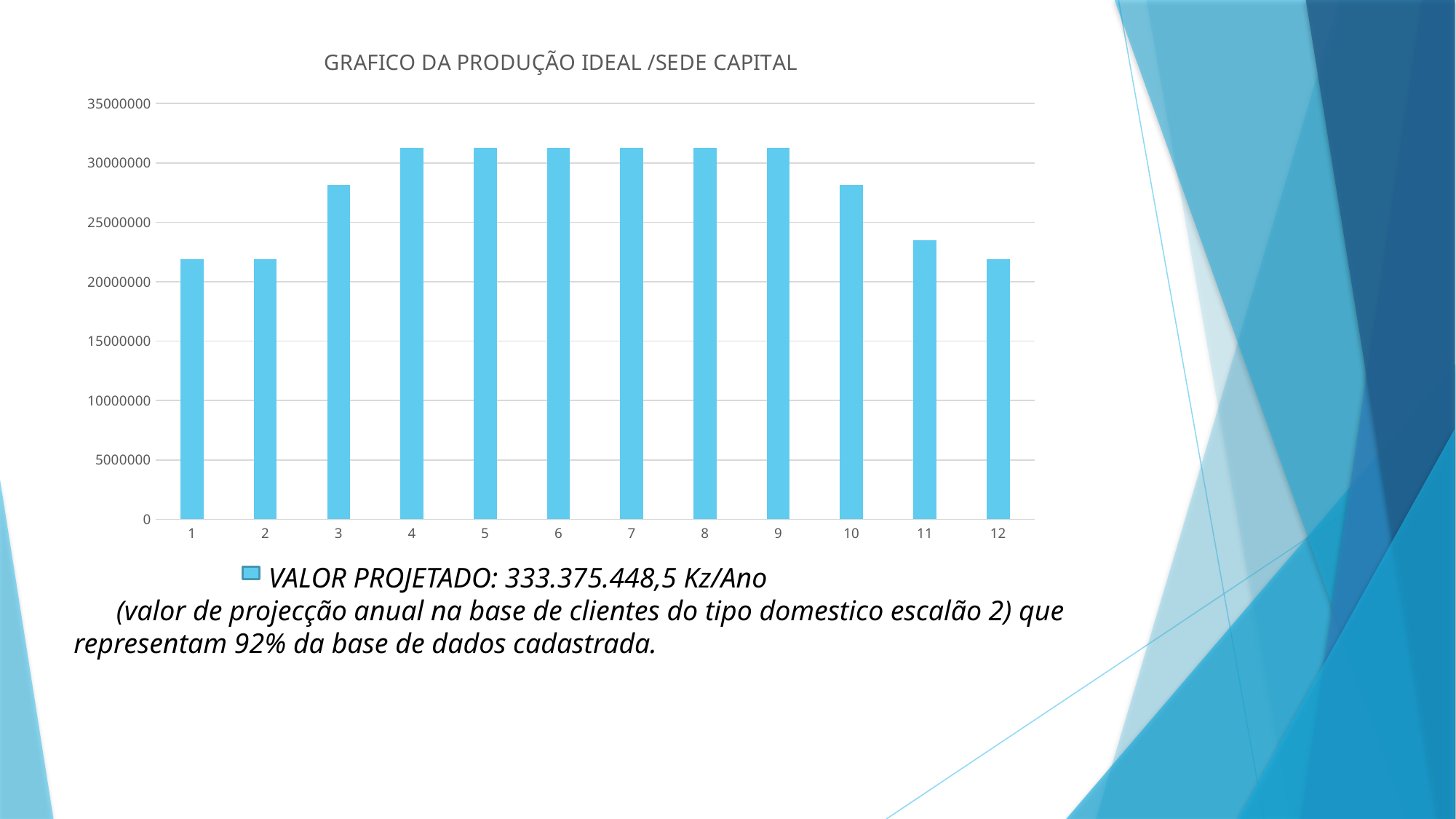
Which has the larger value, category 11 or category 12? 11 Do the values rise or fall from category 9 to category 12? fall How many categories are plotted along the x axis? 12 Which has the larger value, category 3 or category 4? 4 Is the value for category 11 greater or less than 25000000? less Is the value for category 1 greater or less than 20000000? greater Is the value for category 3 greater or less than 30000000? less What kind of chart is shown on the slide? bar chart What is the title of the chart? GRAFICO DA PRODUÇÃO IDEAL /SEDE CAPITAL Do the values rise or fall from category 1 to category 4? rise